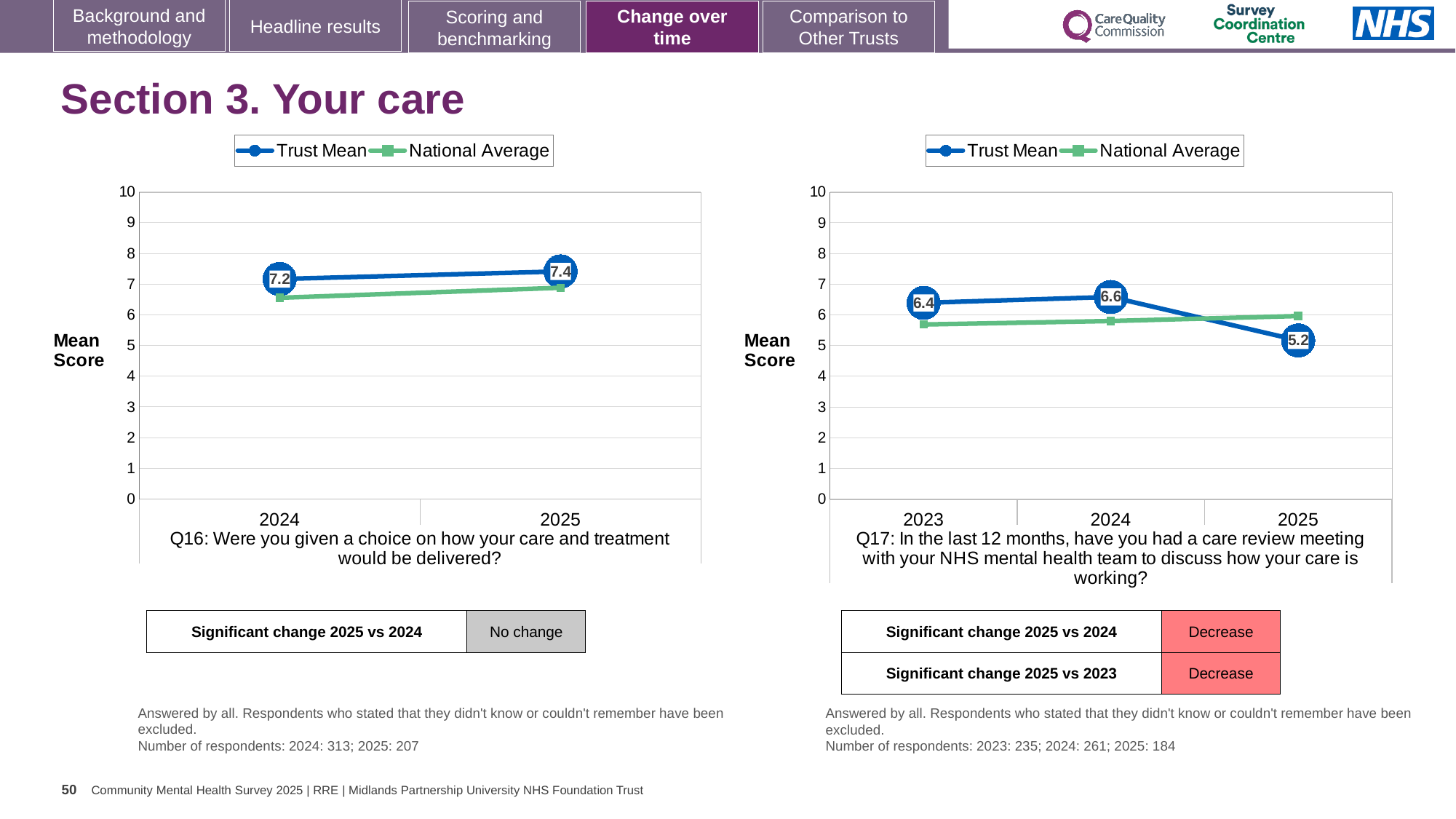
In the Q16 chart on the left, is the Trust Mean for 2025 larger or smaller than for 2024? larger In the Q16 chart on the left, what is the Trust Mean for 2025? 7.4 How many years are shown on the x axis of the Q17 chart on the right? 3 In the Q16 chart on the left, what is the Trust Mean for 2024? 7.2 How many series does the legend of the Q16 chart on the left list? 2 In the Q17 chart on the right, is the National Average for 2023 greater or less than 6? less In the Q17 chart on the right, which year has the lowest Trust Mean? 2025 In the Q17 chart on the right, what is the Trust Mean for 2025? 5.2 In the Q17 chart on the right, which year has the highest Trust Mean? 2024 What kind of chart is the Q16 chart on the left? line chart In the Q17 chart on the right, what is the difference between the Trust Mean for 2024 and 2025? 1.4 In the Q17 chart on the right, what is the Trust Mean for 2023? 6.4